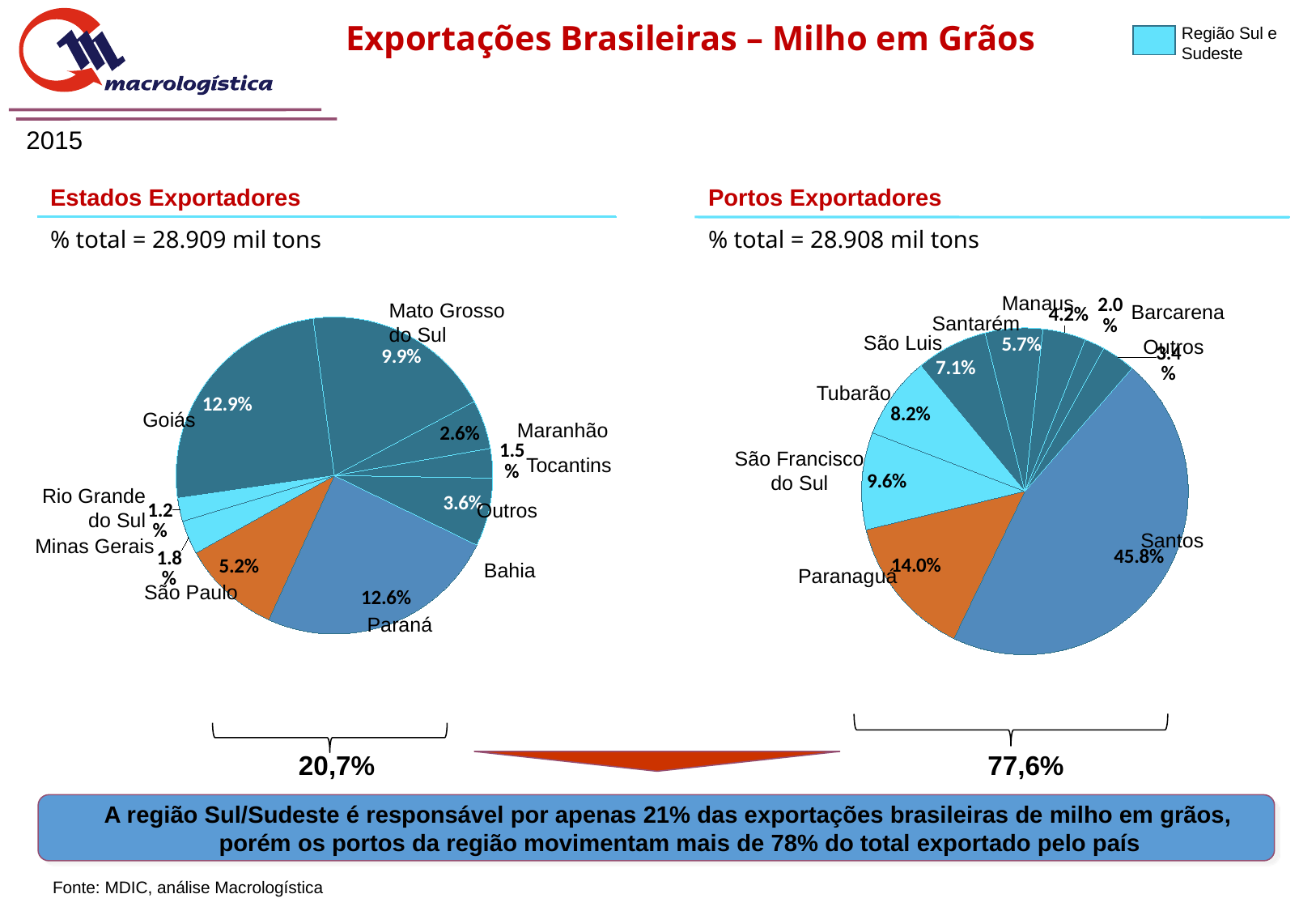
In the Portos Exportadores pie chart, what is the share for Paranaguá? 14.0% In the Portos Exportadores pie chart, what is the difference in percentage points between Santos and Paranaguá? 31.8 In the Portos Exportadores pie chart, which port has the largest share? Santos In the Estados Exportadores pie chart, what is the share for São Paulo? 5.2% In the Portos Exportadores pie chart, how many slices are labelled? 9 In the Portos Exportadores pie chart, what share does Santos have? 45.8% In the Portos Exportadores pie chart, what is the share for Tubarão? 8.2% In the Portos Exportadores pie chart, which labelled port has the smallest share? Barcarena In the Estados Exportadores pie chart, what is the share for Paraná? 12.6% In the Estados Exportadores pie chart, what is the share for Goiás? 12.9% What type of chart is used for Estados Exportadores and Portos Exportadores? Pie chart In the Estados Exportadores pie chart, which has the larger share, Goiás or Paraná? Goiás